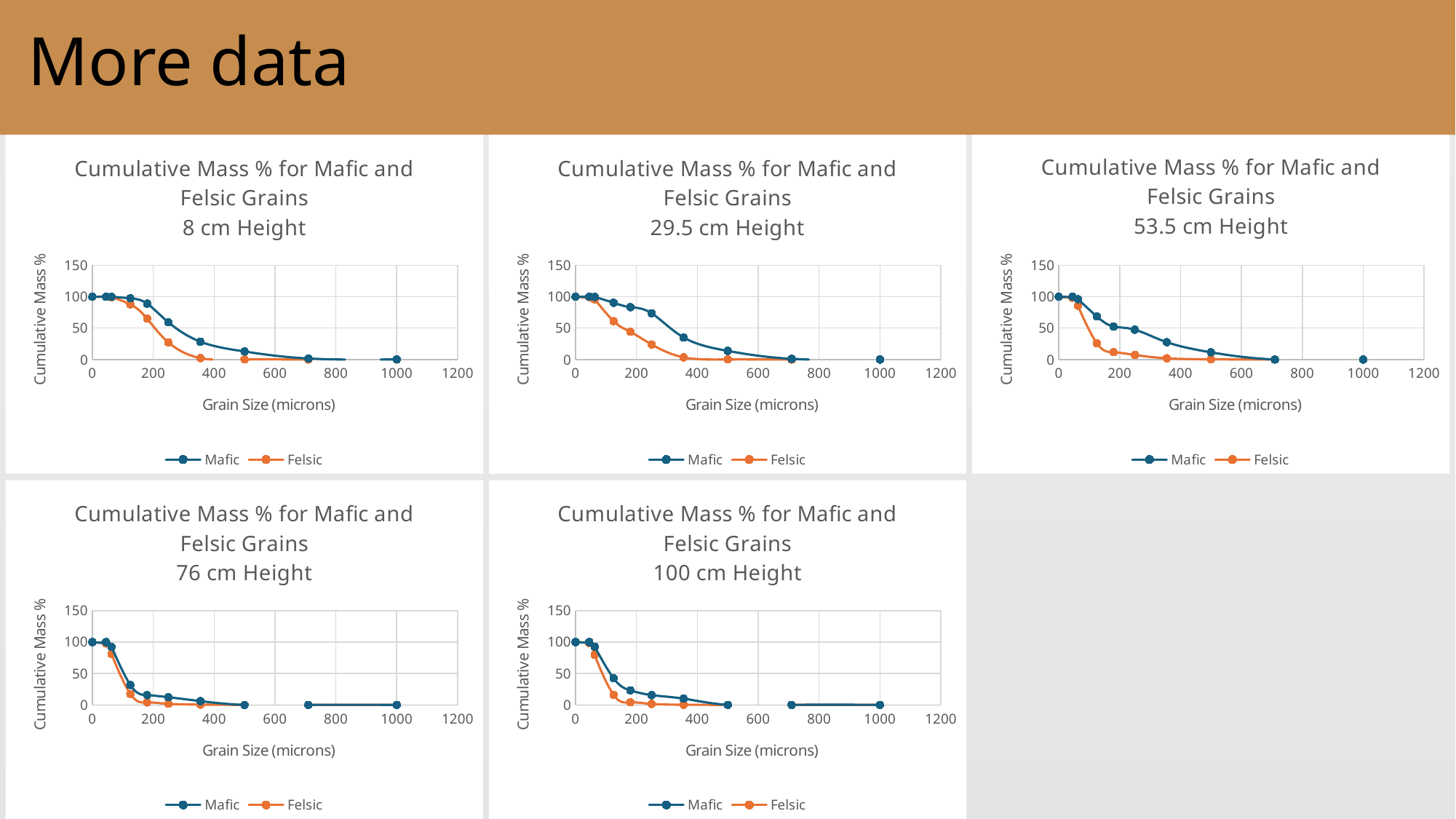
In the '8 cm Height' chart, is the Felsic value at a grain size of 250 microns greater or less than 50? less In the '53.5 cm Height' chart, do the Mafic values rise or fall as grain size increases? Fall In the '100 cm Height' chart, what is the Mafic cumulative mass % at a grain size of 0 microns? 100 In the '53.5 cm Height' chart, is the Felsic value at a grain size of 125 microns greater or less than 50? less In the '8 cm Height' chart, is the Mafic value at a grain size of 250 microns greater or less than 50? greater What is the label of the x axis on the '76 cm Height' chart? Grain Size (microns) How many charts are shown on the slide? 5 How many series does the legend of the '29.5 cm Height' chart list? 2 In the '29.5 cm Height' chart, which series has the larger value at a grain size of 250 microns, Mafic or Felsic? Mafic What kind of chart is the 'Cumulative Mass % for Mafic and Felsic Grains 8 cm Height' chart? Line chart